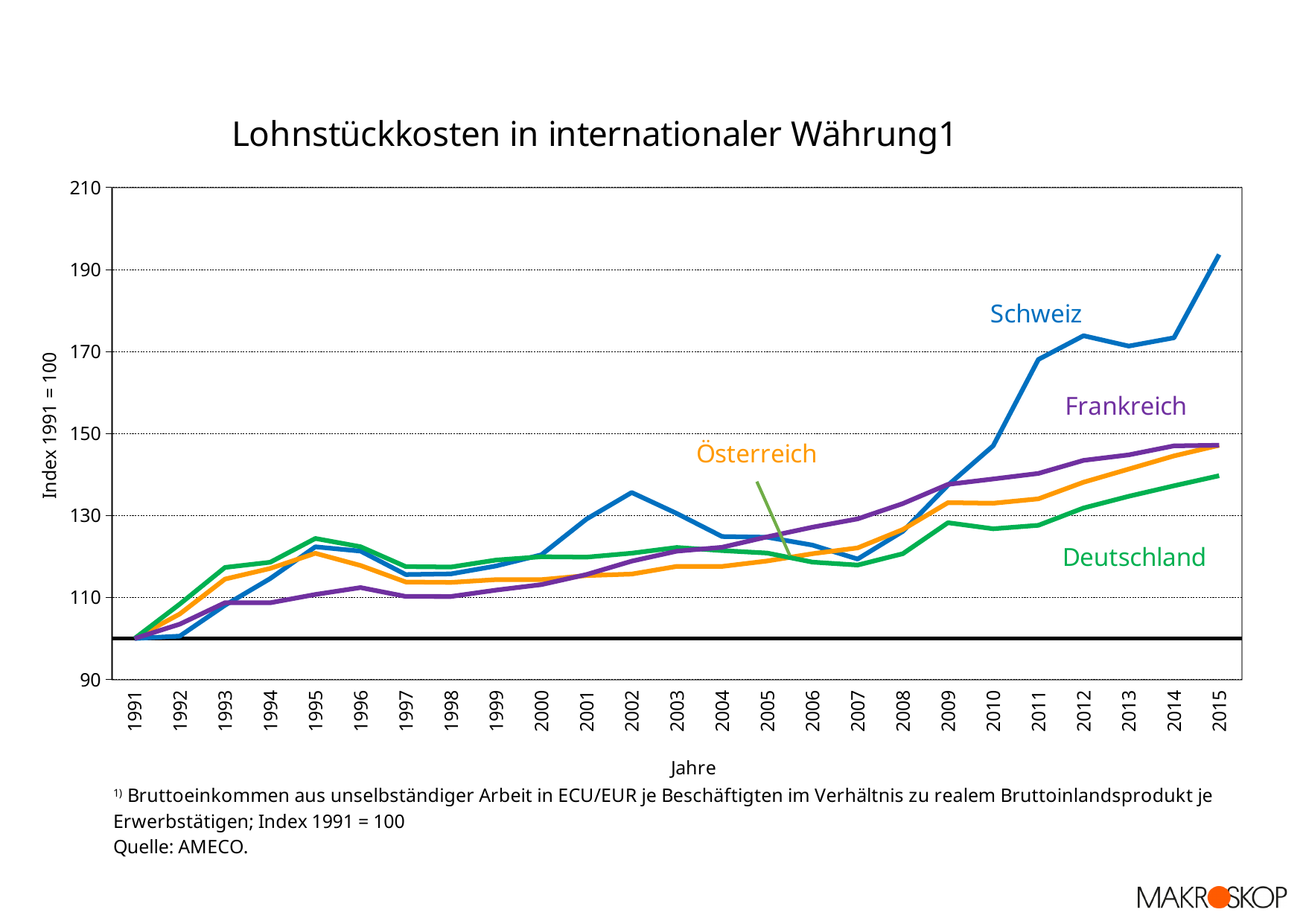
Is the value for Schweiz in 2015 greater or less than 190? greater Which country has the lowest value in 2015? Deutschland What kind of chart is shown on the slide? line chart Is the value for Frankreich in 2015 greater or less than 150? less Is the value for Deutschland in 2015 greater or less than 130? greater Which country has the highest value in 2015? Schweiz Does the value for Schweiz rise or fall between 2009 and 2015? rise How many years are shown on the x axis of the chart? 25 What is the index value of all four countries in 1991? 100 Which is larger in 1995, the value for Deutschland or the value for Frankreich? Deutschland How many countries (series) are plotted in the chart? 4 What is the title of the chart? Lohnstückkosten in internationaler Währung1